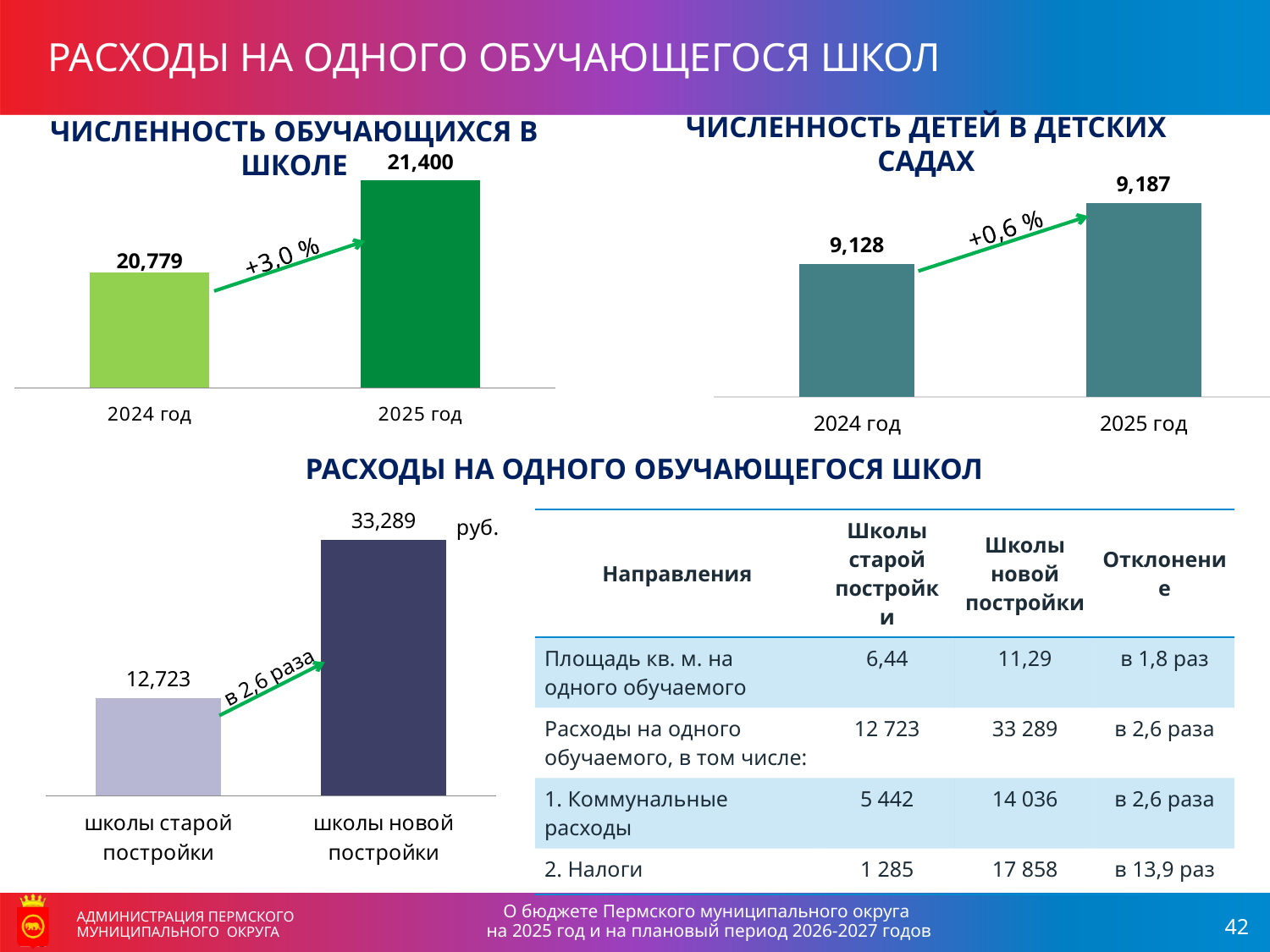
In the chart 'ЧИСЛЕННОСТЬ ОБУЧАЮЩИХСЯ В ШКОЛЕ', what is the value for 2024 год? 20,779 In the chart 'ЧИСЛЕННОСТЬ ДЕТЕЙ В ДЕТСКИХ САДАХ', do the values rise or fall from 2024 год to 2025 год? rise In the chart 'РАСХОДЫ НА ОДНОГО ОБУЧАЮЩЕГОСЯ ШКОЛ' at the bottom left, what is the value for школы новой постройки? 33,289 In the chart 'ЧИСЛЕННОСТЬ ОБУЧАЮЩИХСЯ В ШКОЛЕ', what percentage change is shown on the arrow between the two bars? +3,0 % In the chart 'ЧИСЛЕННОСТЬ ДЕТЕЙ В ДЕТСКИХ САДАХ', what is the difference between the 2025 год and 2024 год values? 59 In the chart 'ЧИСЛЕННОСТЬ ОБУЧАЮЩИХСЯ В ШКОЛЕ', what is the difference between the 2025 год and 2024 год values? 621 In the chart 'РАСХОДЫ НА ОДНОГО ОБУЧАЮЩЕГОСЯ ШКОЛ' at the bottom left, which category has the higher value? школы новой постройки In the chart 'ЧИСЛЕННОСТЬ ДЕТЕЙ В ДЕТСКИХ САДАХ', what is the value for 2025 год? 9,187 In the chart 'РАСХОДЫ НА ОДНОГО ОБУЧАЮЩЕГОСЯ ШКОЛ' at the bottom left, what is the value for школы старой постройки? 12,723 In the chart 'ЧИСЛЕННОСТЬ ОБУЧАЮЩИХСЯ В ШКОЛЕ', what is the value for 2025 год? 21,400 In the chart 'ЧИСЛЕННОСТЬ ДЕТЕЙ В ДЕТСКИХ САДАХ', what is the value for 2024 год? 9,128 What type of chart is 'РАСХОДЫ НА ОДНОГО ОБУЧАЮЩЕГОСЯ ШКОЛ' at the bottom left of the slide? bar chart